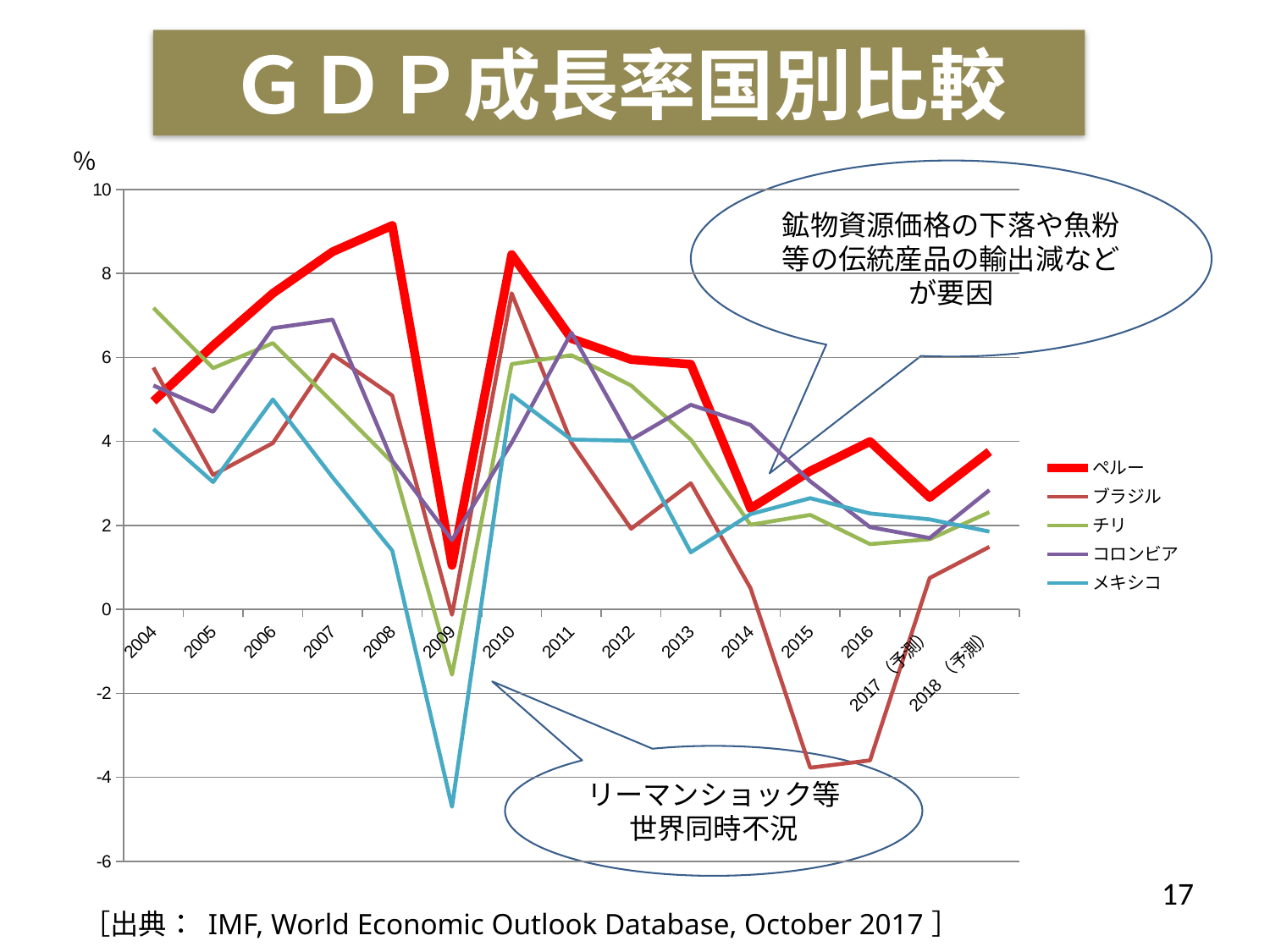
Does the value for ペルー rise or fall from 2004 to 2008? rise Is the value for ブラジル in 2015 greater or less than -2? less What kind of chart is shown on the slide? line chart Which country has the lowest GDP growth rate in 2015? ブラジル Is the value for メキシコ in 2009 greater or less than -4? less How many series does the legend list? 5 How many years are shown along the x axis? 15 Is the value for ペルー in 2008 greater or less than 8? greater Which country has the highest GDP growth rate in 2008? ペルー In 2015, which is larger, the value for ペルー or the value for ブラジル? ペルー Which country has the lowest GDP growth rate in 2009? メキシコ Which series is drawn with the thick red line? ペルー